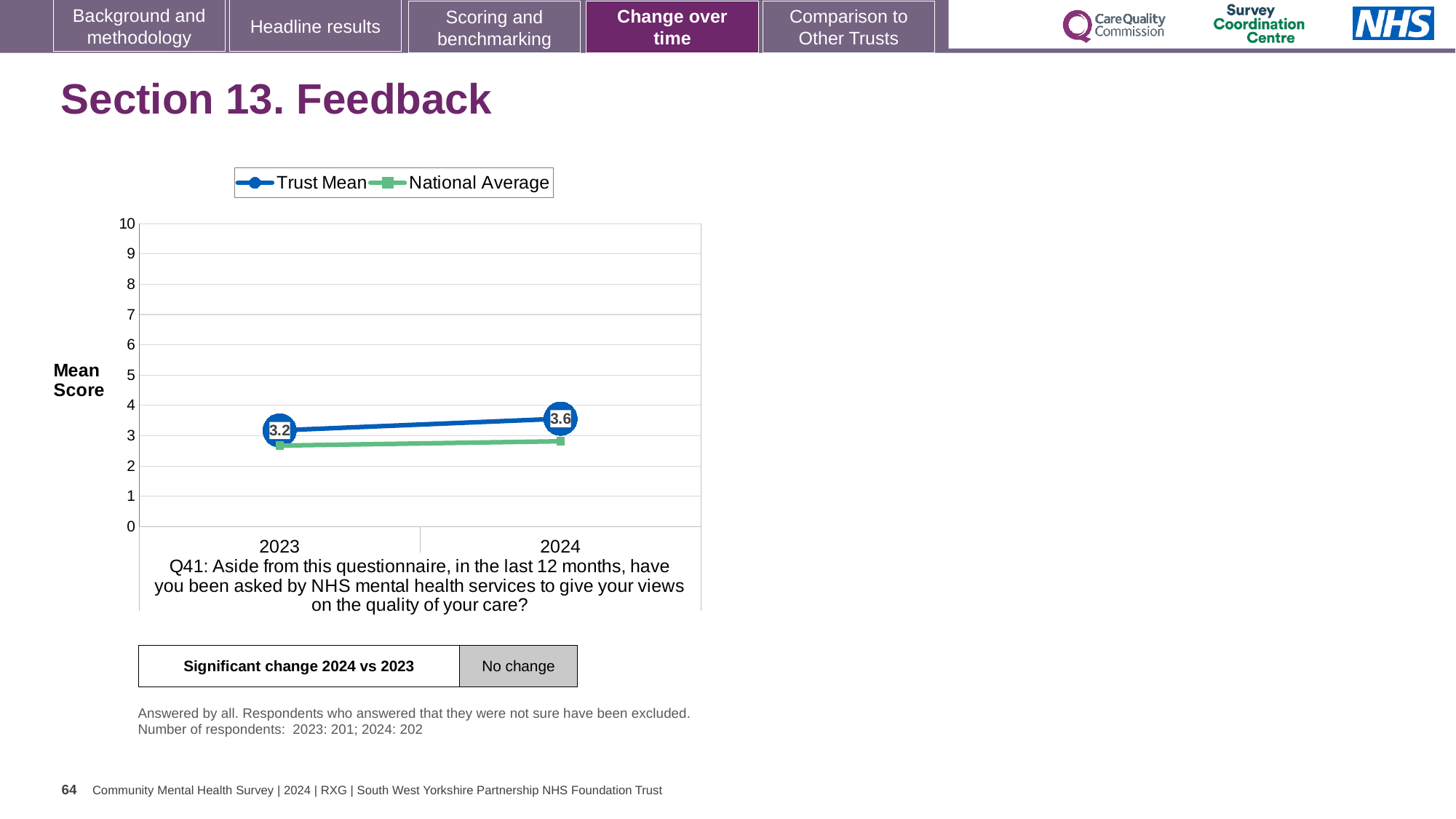
In which year is the Trust Mean higher? 2024 What is the Trust Mean score for 2023? 3.2 In 2024, which is larger: the Trust Mean or the National Average? Trust Mean How many series does the legend list? 2 Is the National Average value for 2023 greater or less than 3? less What is the Trust Mean score for 2024? 3.6 Is the Trust Mean value for 2024 greater or less than 4? less What is the label on the y axis of the chart? Mean Score How many years are plotted on the x axis? 2 What kind of chart is shown on the slide? line chart By how much did the Trust Mean change from 2023 to 2024? 0.4 Does the Trust Mean rise or fall from 2023 to 2024? rise